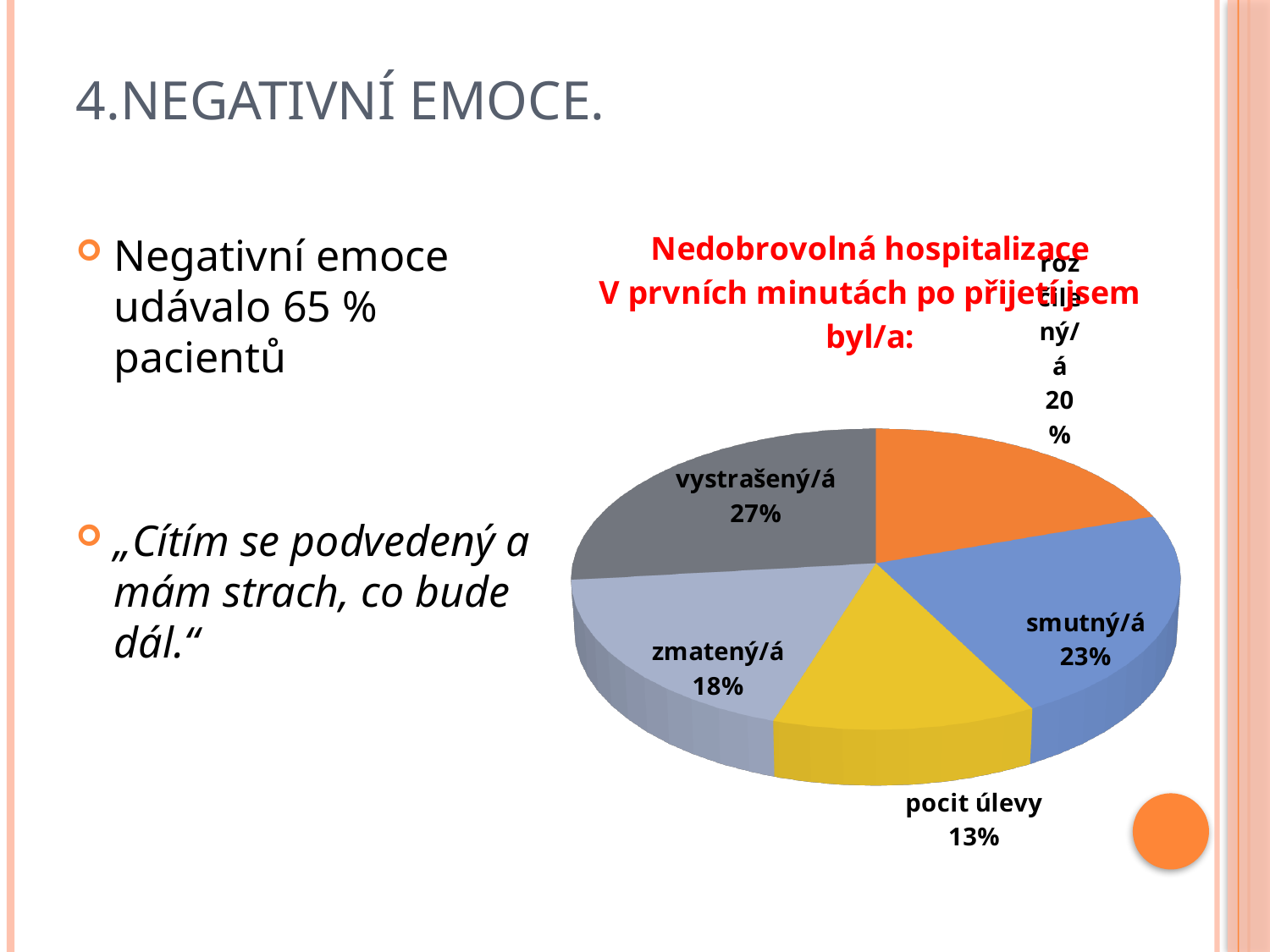
What share of the pie is labelled zmatený/á? 18% What percentage is shown for the orange slice of the pie? 20% Which is larger, zmatený/á or pocit úlevy? zmatený/á Which slice of the pie is the smallest? pocit úlevy How many slices does the pie chart have? 5 What share of the pie is labelled vystrašený/á? 27% By how many percentage points does vystrašený/á exceed smutný/á? 4 What share of the pie is labelled pocit úlevy? 13% What is the first line of the chart's title? Nedobrovolná hospitalizace What kind of chart is shown on the slide? pie chart Which slice of the pie is the largest? vystrašený/á What share of the pie is labelled smutný/á? 23%